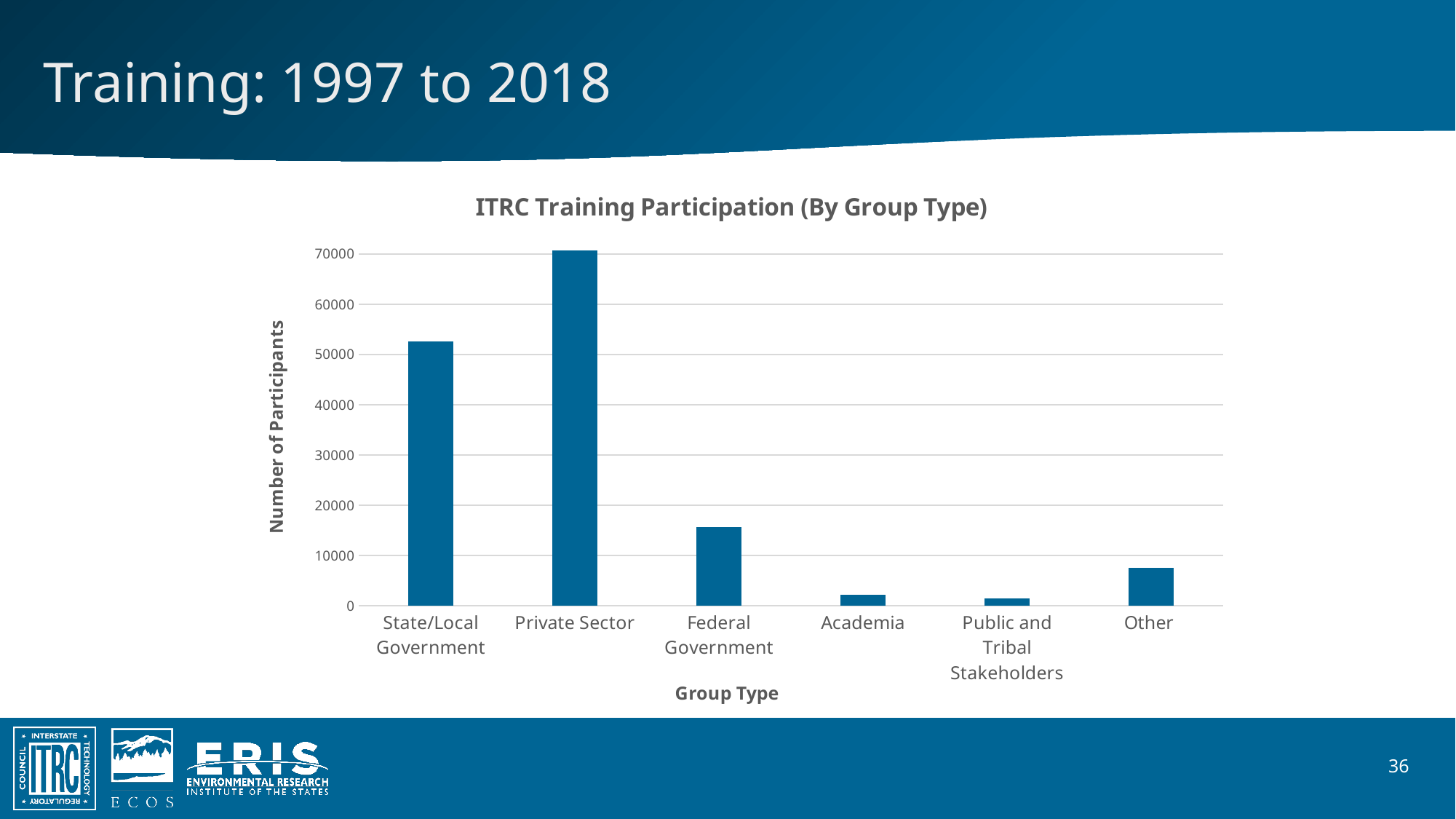
Which group type has the highest number of participants? Private Sector What is the label of the vertical axis? Number of Participants Is the value for Federal Government greater or less than 20000? less Is the value for State/Local Government greater or less than 50000? greater Is the value for Other greater or less than 10000? less What is the title of the chart? ITRC Training Participation (By Group Type) Which has more participants, State/Local Government or Federal Government? State/Local Government Which has more participants, Other or Federal Government? Federal Government How many group types are shown on the x axis of the chart? 6 What kind of chart is shown on the slide? bar chart